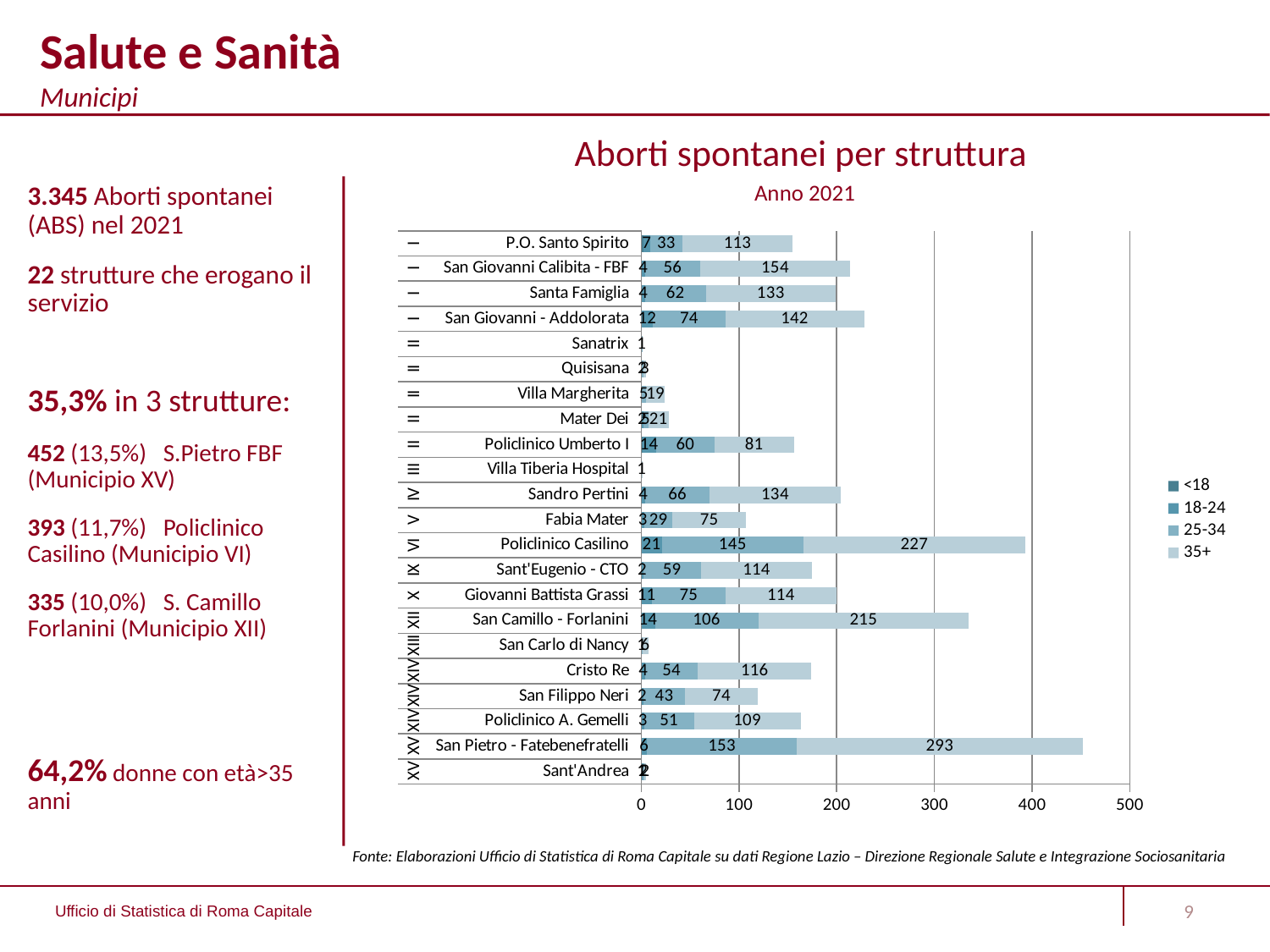
How many series does the legend of the chart list? 4 How many structures (categories) are plotted in the chart? 22 What is the value of the 25-34 series for San Camillo - Forlanini? 106 Which is larger, the 35+ value for Policlinico Casilino or the 35+ value for San Camillo - Forlanini? Policlinico Casilino Which structure has the longest total bar in the chart? San Pietro - Fatebenefratelli What is the value of the 35+ series for Policlinico Casilino? 227 Is the total bar for San Giovanni - Addolorata greater or less than 200? greater What are the four age groups listed in the chart legend? <18, 18-24, 25-34, 35+ What kind of chart is shown on the slide? bar chart What is the total of the stacked bar for San Pietro - Fatebenefratelli (6 + 153 + 293)? 452 What is the difference between the 35+ value for San Pietro - Fatebenefratelli and the 35+ value for Policlinico Casilino? 66 What is the value of the 35+ series for San Pietro - Fatebenefratelli? 293